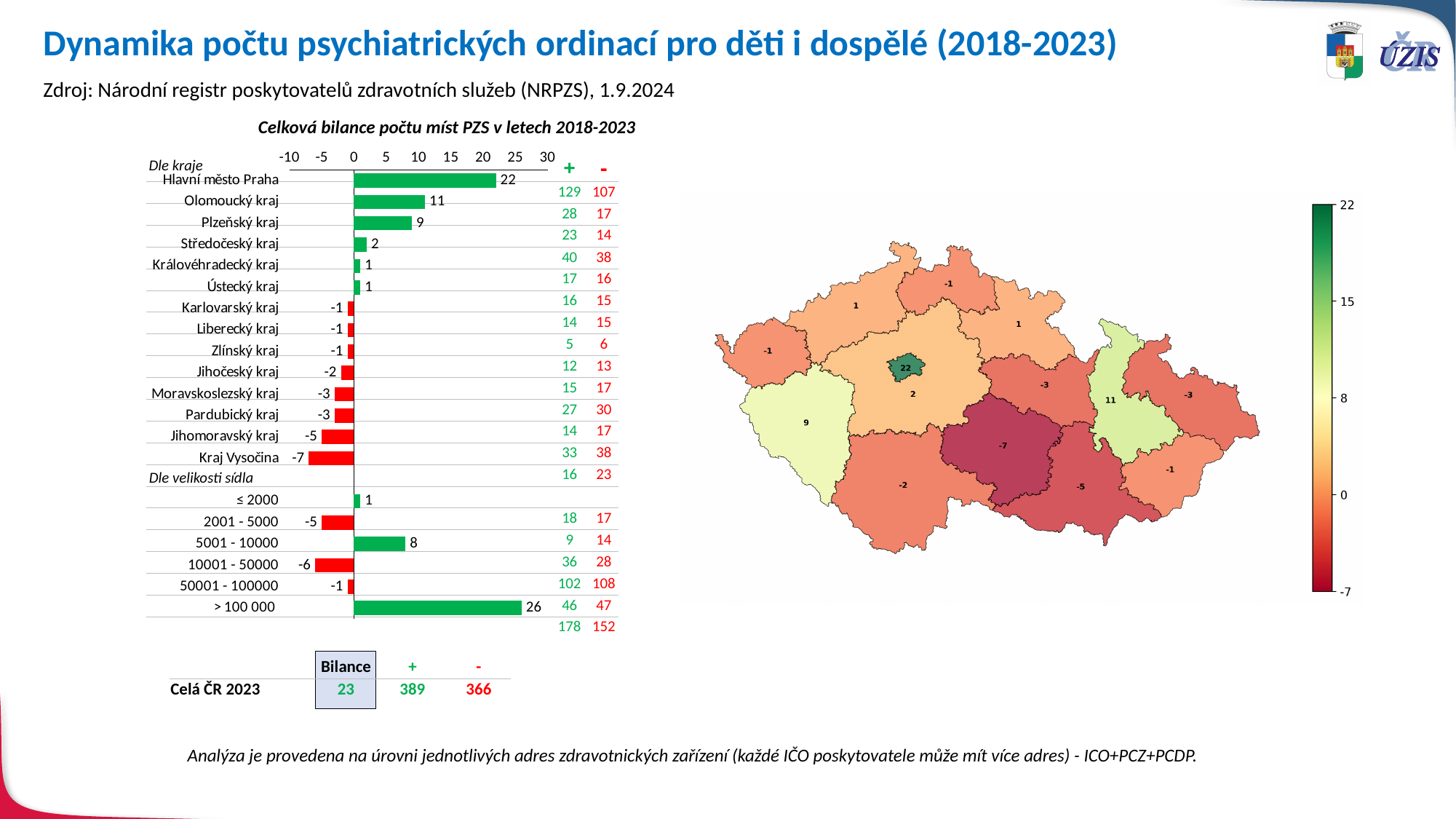
In the bar chart 'Celková bilance počtu míst PZS v letech 2018-2023', what is the difference between the values for Hlavní město Praha and Olomoucký kraj? 11 In the bar chart 'Celková bilance počtu míst PZS v letech 2018-2023', which is larger: the value for Plzeňský kraj or the value for Středočeský kraj? Plzeňský kraj In the bar chart 'Celková bilance počtu míst PZS v letech 2018-2023', how many regions (kraje) are listed under 'Dle kraje'? 14 In the bar chart 'Celková bilance počtu míst PZS v letech 2018-2023', what is the value for the size category '> 100 000'? 26 In the bar chart 'Celková bilance počtu míst PZS v letech 2018-2023', which region (kraj) has the lowest value? Kraj Vysočina In the bar chart 'Celková bilance počtu míst PZS v letech 2018-2023', what is the value for the size category '10001 - 50000'? -6 What kind of chart is 'Celková bilance počtu míst PZS v letech 2018-2023'? Bar chart In the bar chart 'Celková bilance počtu míst PZS v letech 2018-2023', how many settlement-size categories are listed under 'Dle velikosti sídla'? 6 In the bar chart 'Celková bilance počtu míst PZS v letech 2018-2023', what is the value for Olomoucký kraj? 11 In the bar chart 'Celková bilance počtu míst PZS v letech 2018-2023', what is the value for Kraj Vysočina? -7 In the bar chart 'Celková bilance počtu míst PZS v letech 2018-2023', what is the value for Hlavní město Praha? 22 In the bar chart 'Celková bilance počtu míst PZS v letech 2018-2023', which region (kraj) has the highest value? Hlavní město Praha